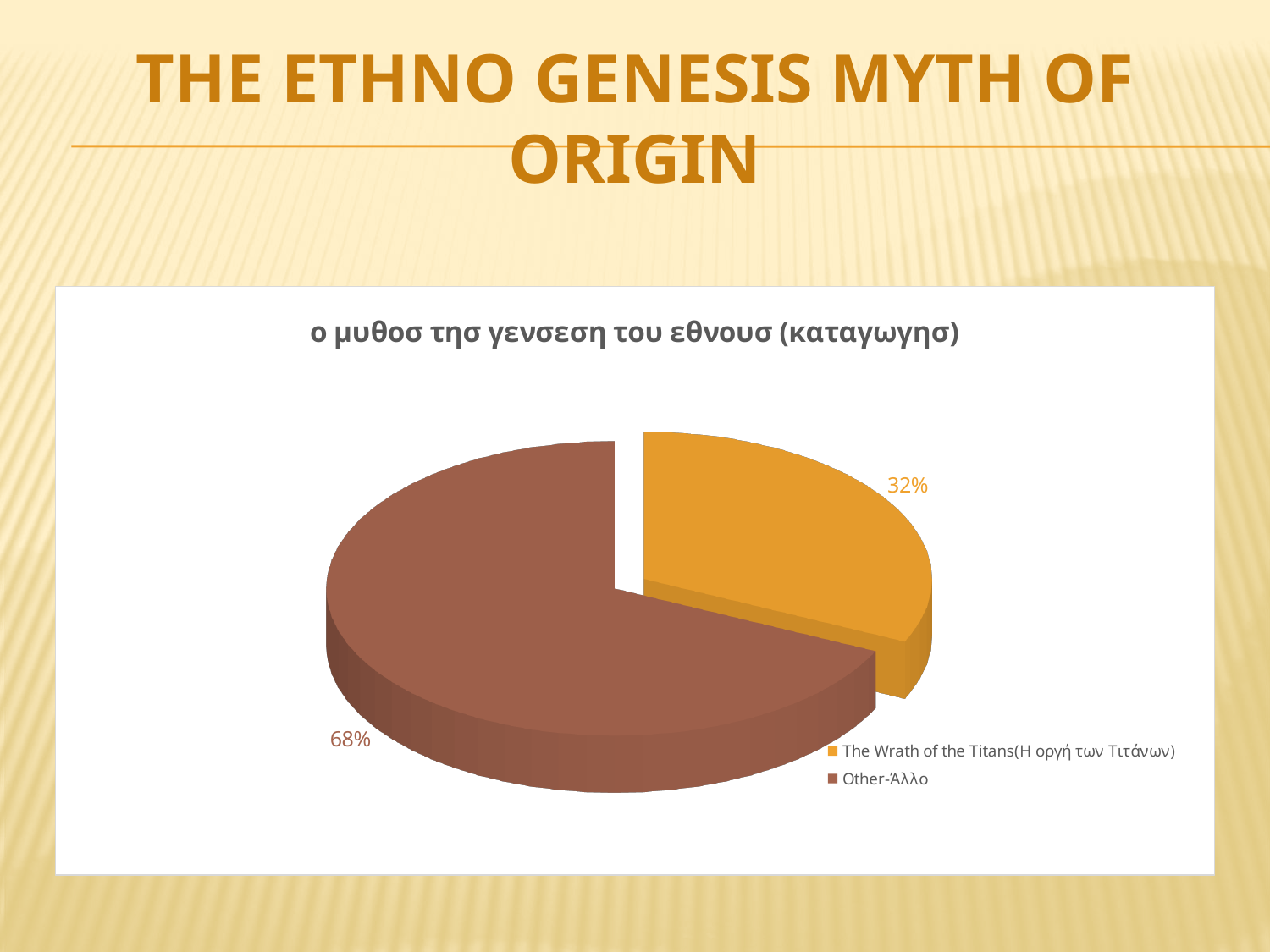
Which slice of the pie is the smallest? The Wrath of the Titans(Η οργή των Τιτάνων) How many entries does the legend list? 2 Which slice of the pie is the largest? Other-Άλλο What share of the pie does "Other-Άλλο" have? 68% What share of the pie does "The Wrath of the Titans(Η οργή των Τιτάνων)" have? 32% What kind of chart is shown on the slide? pie chart What colour is the "The Wrath of the Titans(Η οργή των Τιτάνων)" slice? orange Which is larger: the "Other-Άλλο" slice or the "The Wrath of the Titans(Η οργή των Τιτάνων)" slice? Other-Άλλο What is the difference in percentage points between the "Other-Άλλο" slice and the "The Wrath of the Titans(Η οργή των Τιτάνων)" slice? 36 percentage points What is the title of the chart? ο μυθοσ τησ γενσεση του εθνουσ (καταγωγησ) How many slices does the pie chart have? 2